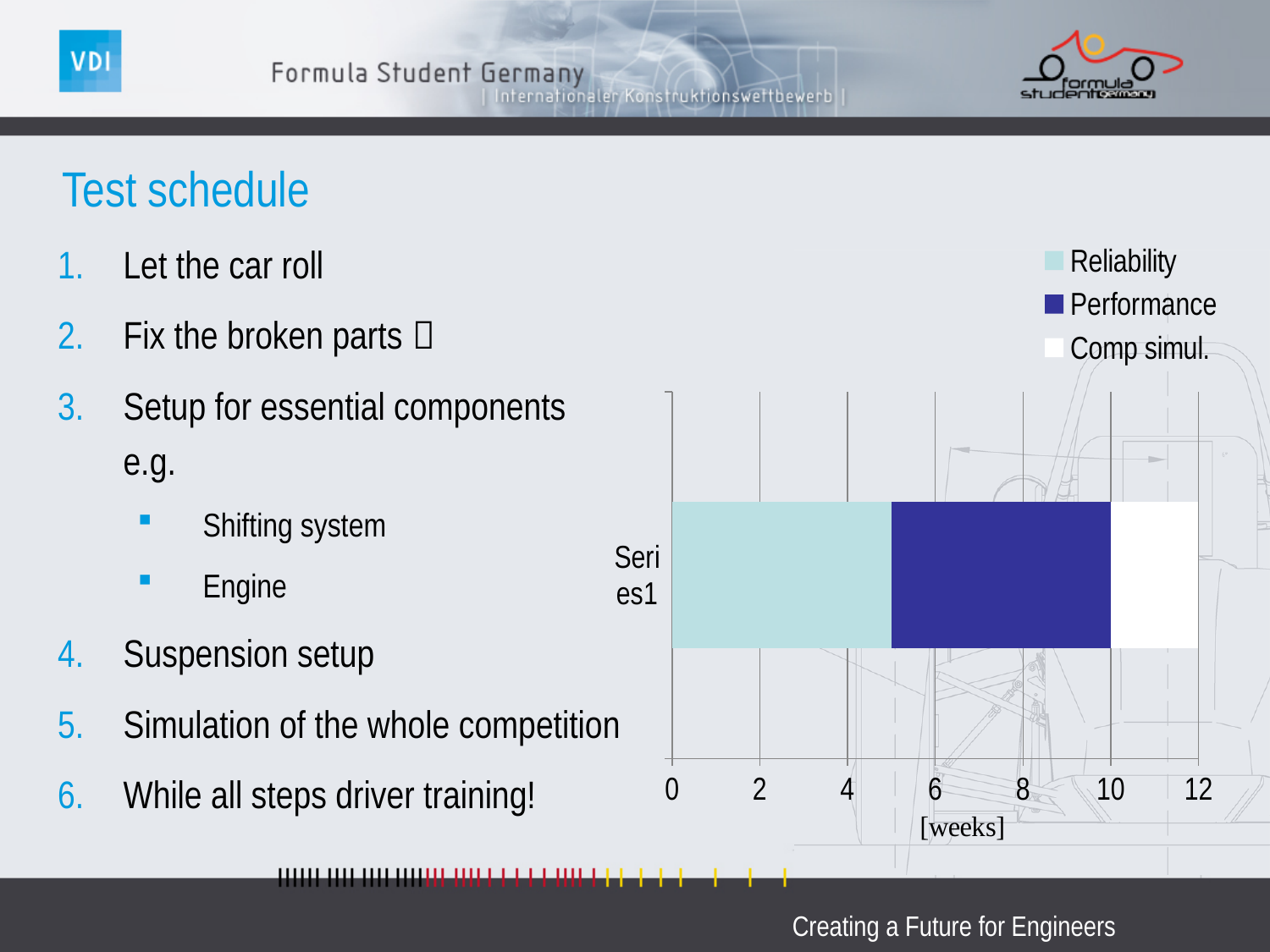
Is the value for Reliability greater or less than 6? less Is the total length of the Series1 bar greater or less than 10? greater Which series has the smallest segment in the stacked bar? Comp simul. How many categories are plotted on the chart's vertical axis? 1 What kind of chart is shown on the slide? bar chart What unit is shown on the chart's horizontal axis? [weeks] At what week value does the stacked bar for Series1 end? 12 Which series is listed first in the chart legend? Reliability Is the value for Comp simul. greater or less than 4? less How many series does the chart legend list? 3 Which is larger, the Reliability segment or the Comp simul. segment? Reliability